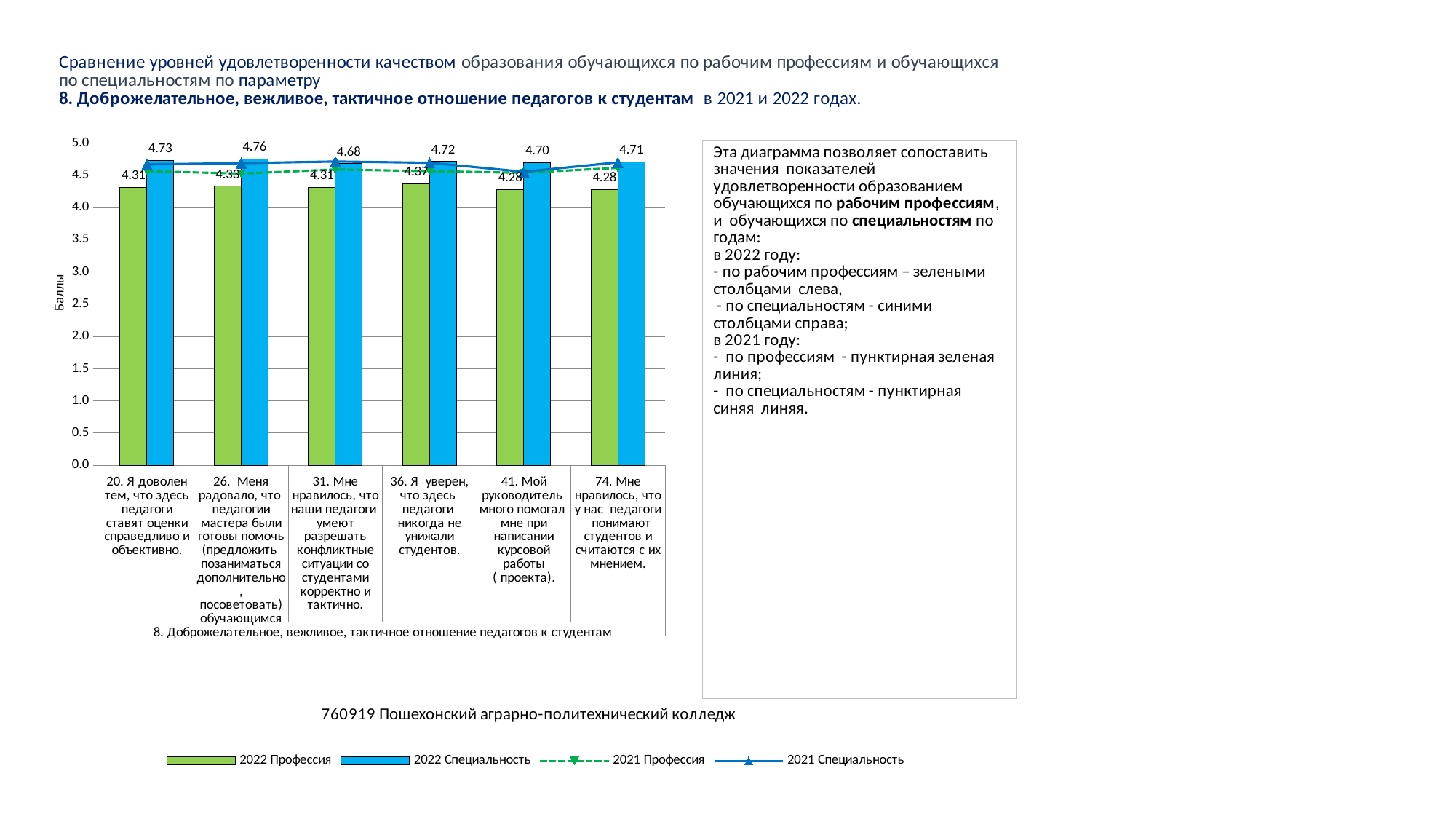
What is the label of the vertical axis of the chart? Баллы Which category has the highest 2022 Специальность value? 26. Меня радовало, что педагогии мастера были готовы помочь How many categories are shown on the x axis of the chart? 6 Which category has the highest 2022 Профессия value? 36. Я уверен, что здесь педагоги никогда не унижали студентов What is the value of the 2022 Профессия bar for category 36 (Я уверен, что здесь педагоги никогда не унижали студентов)? 4.37 For category 74, which is larger: the 2022 Профессия bar or the 2022 Специальность bar? 2022 Специальность What is the value of the 2022 Специальность bar for category 26 (Меня радовало, что педагогии мастера были готовы помочь...)? 4.76 Is the 2022 Профессия value for category 41 greater or less than 4.5? less How many series does the chart legend list? 4 What is the difference between the 2022 Специальность and 2022 Профессия values for category 20? 0.42 What is the value of the 2022 Специальность bar for category 41 (Мой руководитель много помогал мне при написании курсовой работы)? 4.70 Which category has the lowest 2022 Специальность value? 31. Мне нравилось, что наши педагоги умеют разрешать конфликтные ситуации